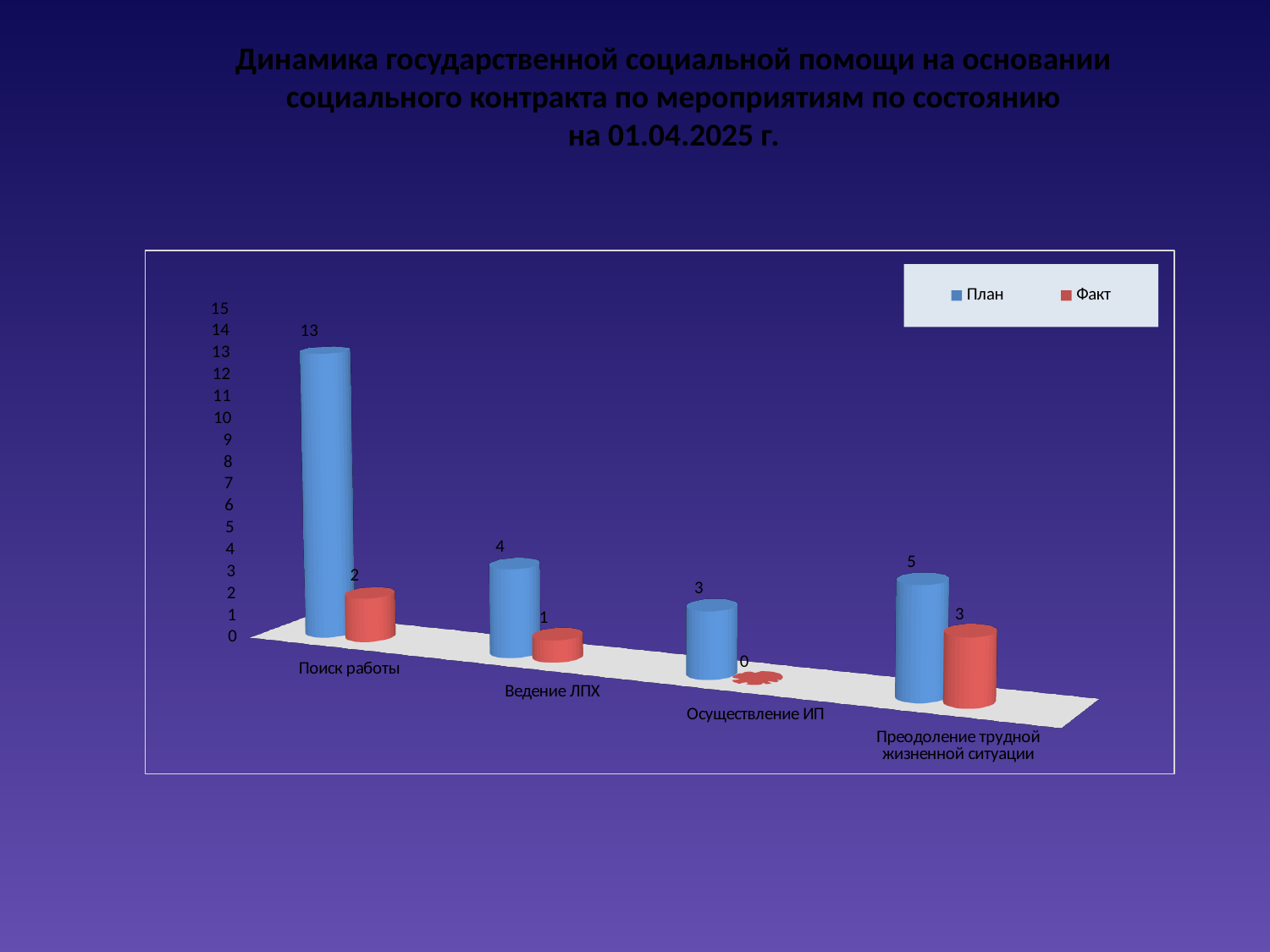
How many series does the legend list? 2 What is the difference between План and Факт for Поиск работы? 11 Which category has the lowest Факт value? Осуществление ИП How many categories are shown on the x axis? 4 What is the План value for Поиск работы? 13 Which category has the highest План value? Поиск работы What is the План value for Преодоление трудной жизненной ситуации? 5 What is the Факт value for Осуществление ИП? 0 What colour represents the Факт series? Red What is the Факт value for Ведение ЛПХ? 1 What kind of chart is shown on the slide? Bar chart Which is larger, the План value for Ведение ЛПХ or the План value for Преодоление трудной жизненной ситуации? Преодоление трудной жизненной ситуации